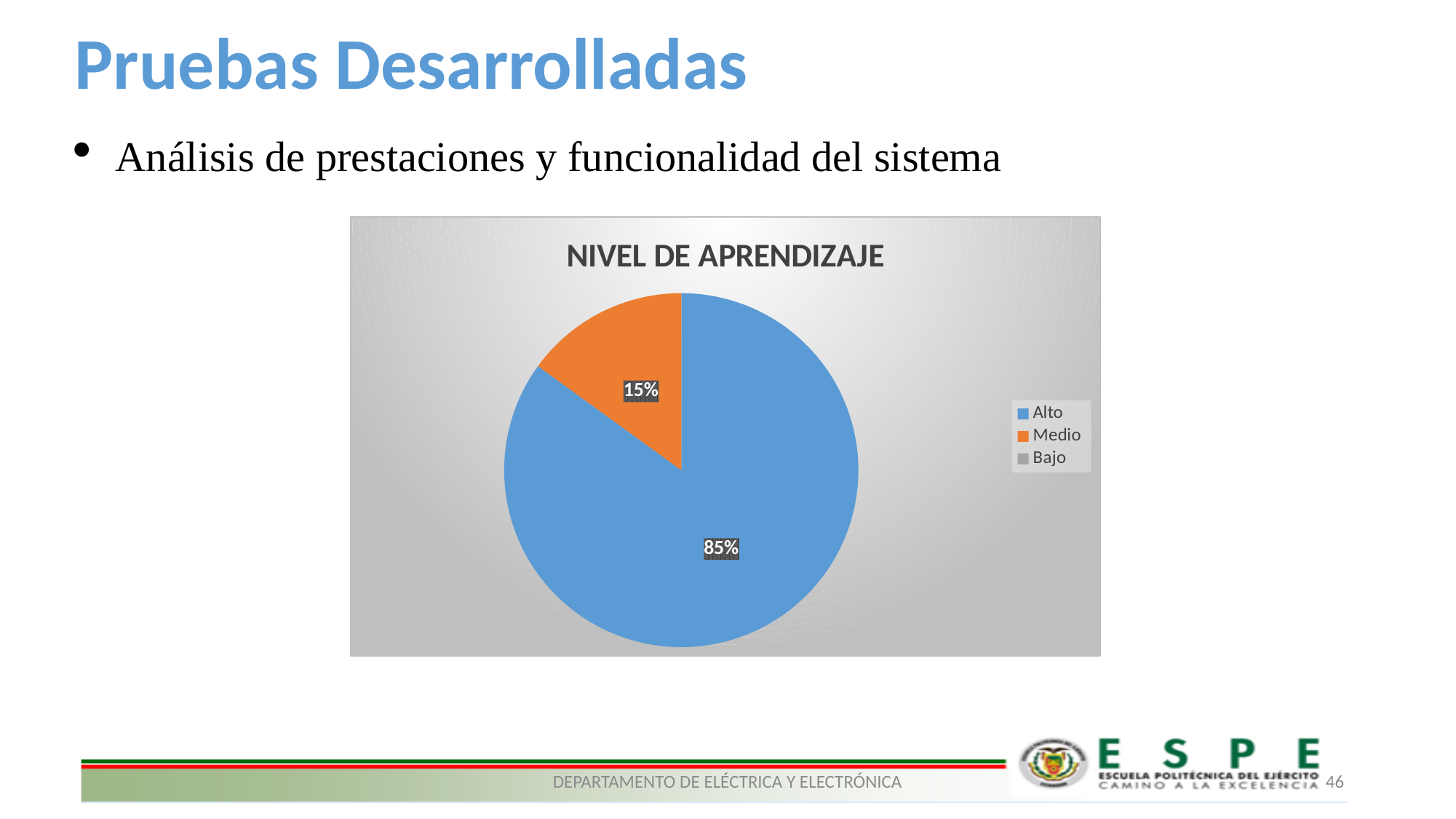
How many slices are visible in the pie? 2 What is the difference between the Alto and Medio shares? 70% What is the title of the chart? NIVEL DE APRENDIZAJE Which category has the largest slice of the pie? Alto What share of the pie does Medio have? 15% Which legend entry has no visible slice in the pie? Bajo Is the share for Alto greater or less than 50%? greater Which of Alto or Medio has the larger slice? Alto How many entries does the legend list? 3 What kind of chart is shown on the slide? pie chart What share of the pie does Alto have? 85%